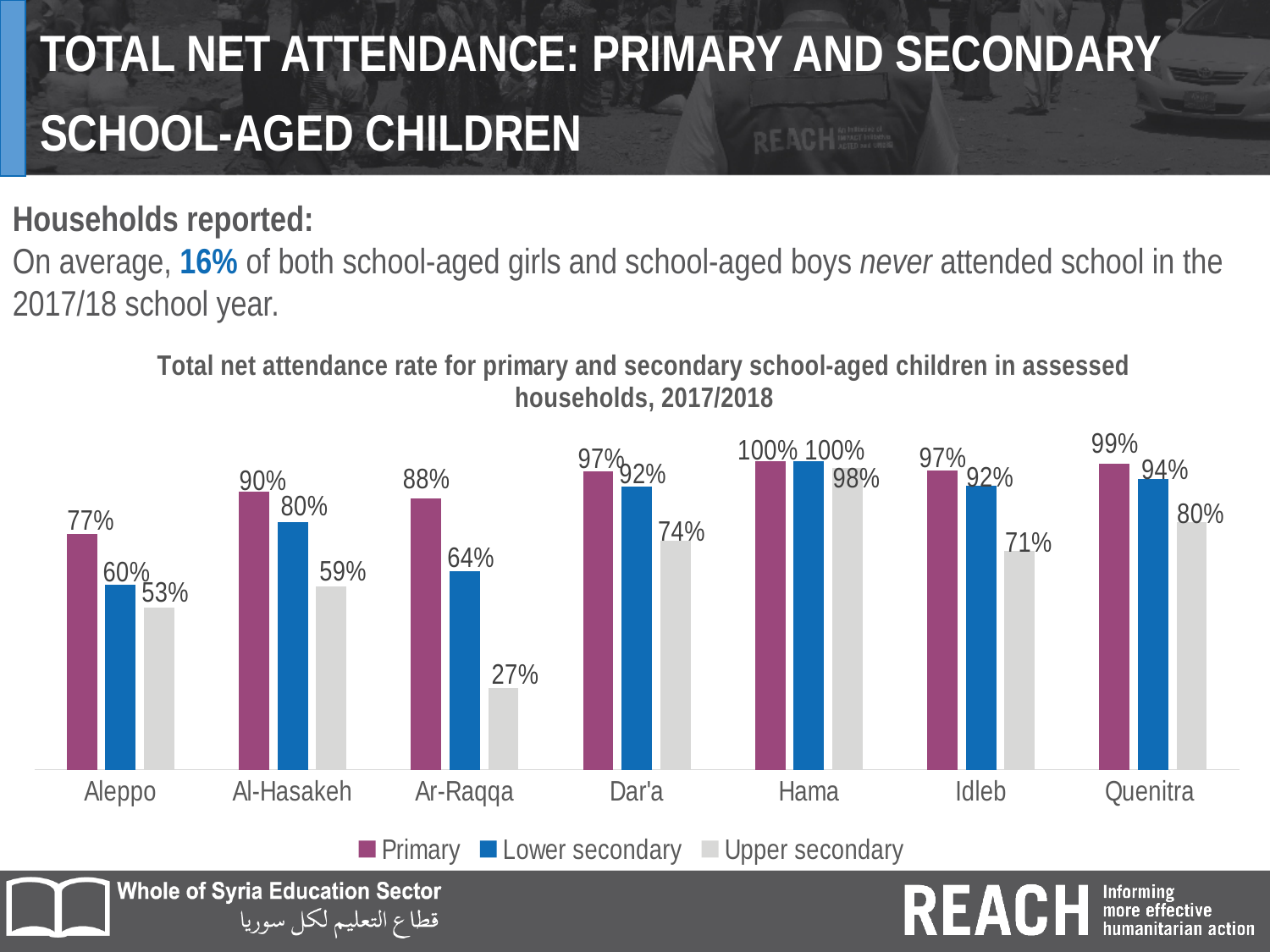
Which is larger: the Upper secondary rate for Dar'a or the Upper secondary rate for Idleb? Dar'a How many series does the legend list? 3 What kind of chart is shown on the slide? Bar chart Which governorate has the lowest Upper secondary net attendance rate? Ar-Raqqa What is the Upper secondary net attendance rate for Ar-Raqqa? 27% What is the Primary net attendance rate for Aleppo? 77% Which governorate has the highest Lower secondary net attendance rate? Hama Which series is shown in blue in the chart? Lower secondary What is the Lower secondary net attendance rate for Quenitra? 94% What is the Upper secondary net attendance rate for Hama? 98% How many governorates are shown on the x axis of the chart? 7 What is the difference between the Primary and Upper secondary rates for Al-Hasakeh? 31%